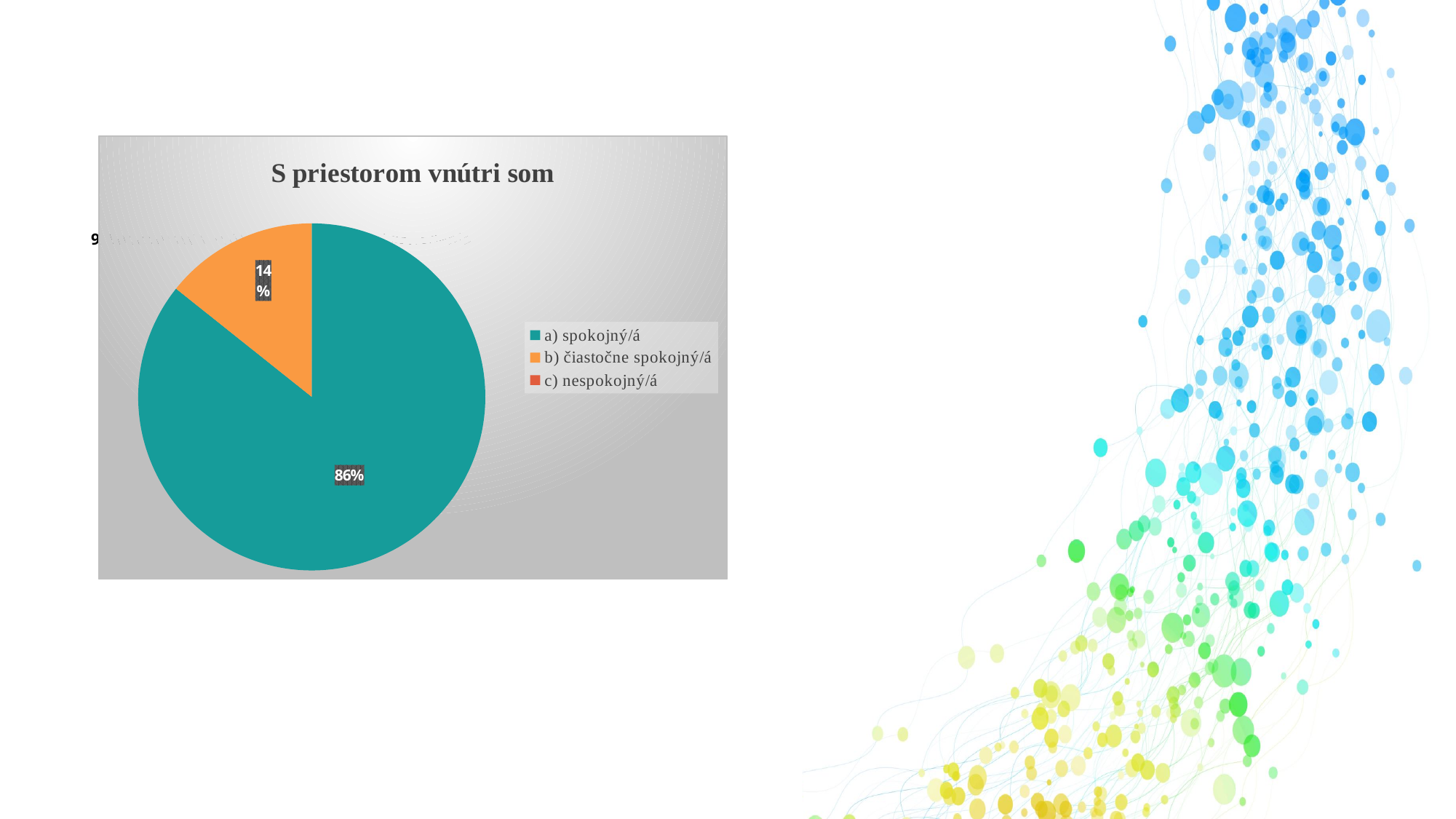
What is the difference in percentage points between the "a) spokojný/á" slice and the "b) čiastočne spokojný/á" slice? 72 percentage points What is the title of the chart? S priestorom vnútri som Which is larger, the slice for "a) spokojný/á" or the slice for "b) čiastočne spokojný/á"? a) spokojný/á What share of the pie does "a) spokojný/á" have? 86% How many entries does the legend list? 3 Is the share for "a) spokojný/á" greater or less than 50%? greater What kind of chart is shown on the slide? pie chart What share of the pie does "b) čiastočne spokojný/á" have? 14% Which category has the largest slice of the pie? a) spokojný/á What colour is the slice for "b) čiastočne spokojný/á"? orange